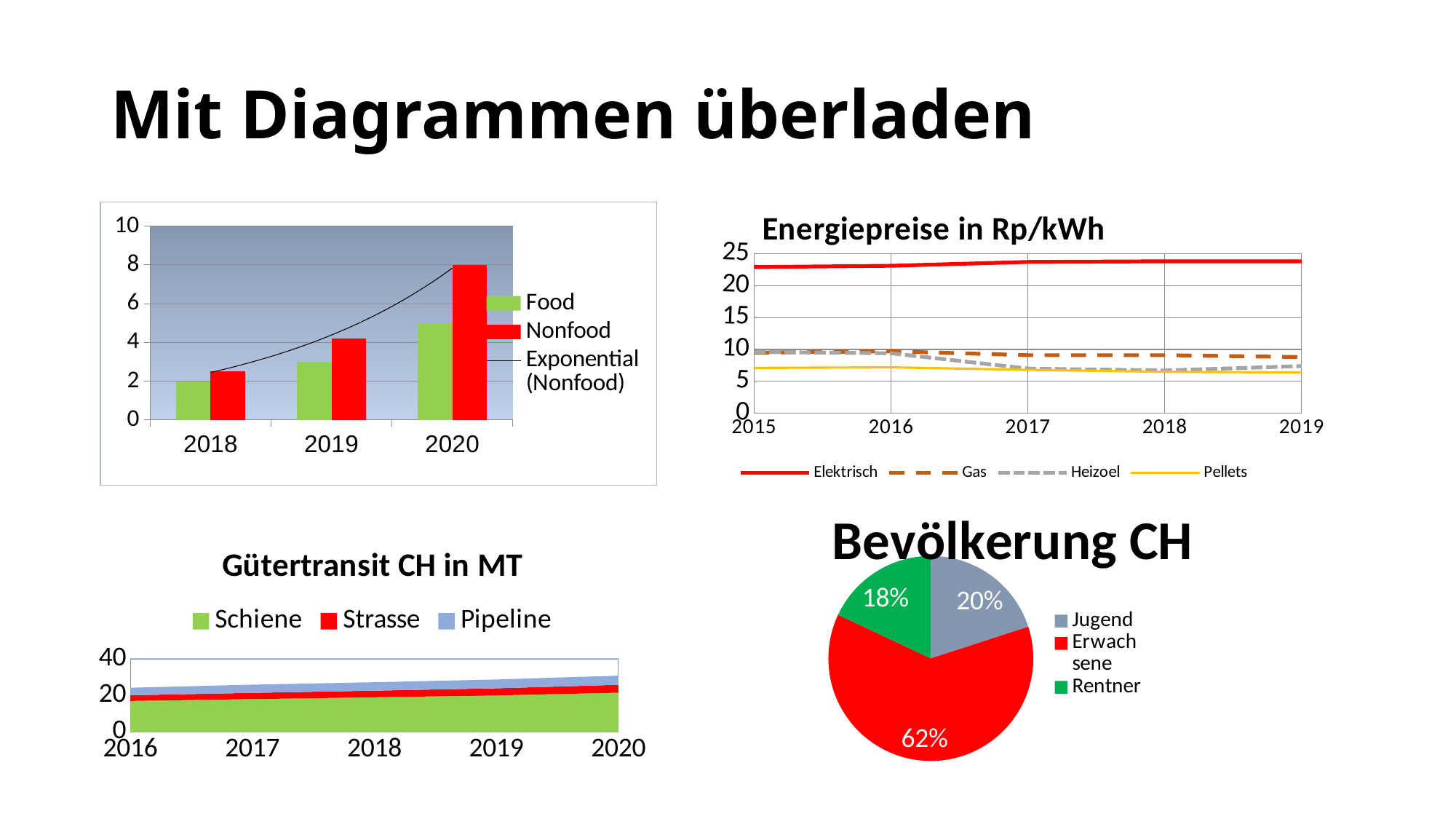
In the 'Bevölkerung CH' pie chart, which slice is the smallest? Rentner In the 'Gütertransit CH in MT' chart, which series does the legend list first? Schiene In the 'Bevölkerung CH' pie chart, which is larger, Jugend or Rentner? Jugend How many series does the legend of the 'Energiepreise in Rp/kWh' chart list? 4 In the 'Bevölkerung CH' pie chart, what share does Erwachsene have? 62% In the 'Energiepreise in Rp/kWh' chart, which series has the highest values? Elektrisch In the top-left bar chart, how many years are shown on the x axis? 3 In the 'Bevölkerung CH' pie chart, how many percentage points larger is Erwachsene than Jugend? 42 What kind of chart is 'Gütertransit CH in MT'? stacked area chart In the 'Energiepreise in Rp/kWh' chart, does the Heizoel line rise or fall from 2015 to 2018? fall In the 'Energiepreise in Rp/kWh' chart, is the value for Elektrisch in 2019 greater or less than 20? greater In the top-left bar chart, what is the value for Nonfood in 2020? 8